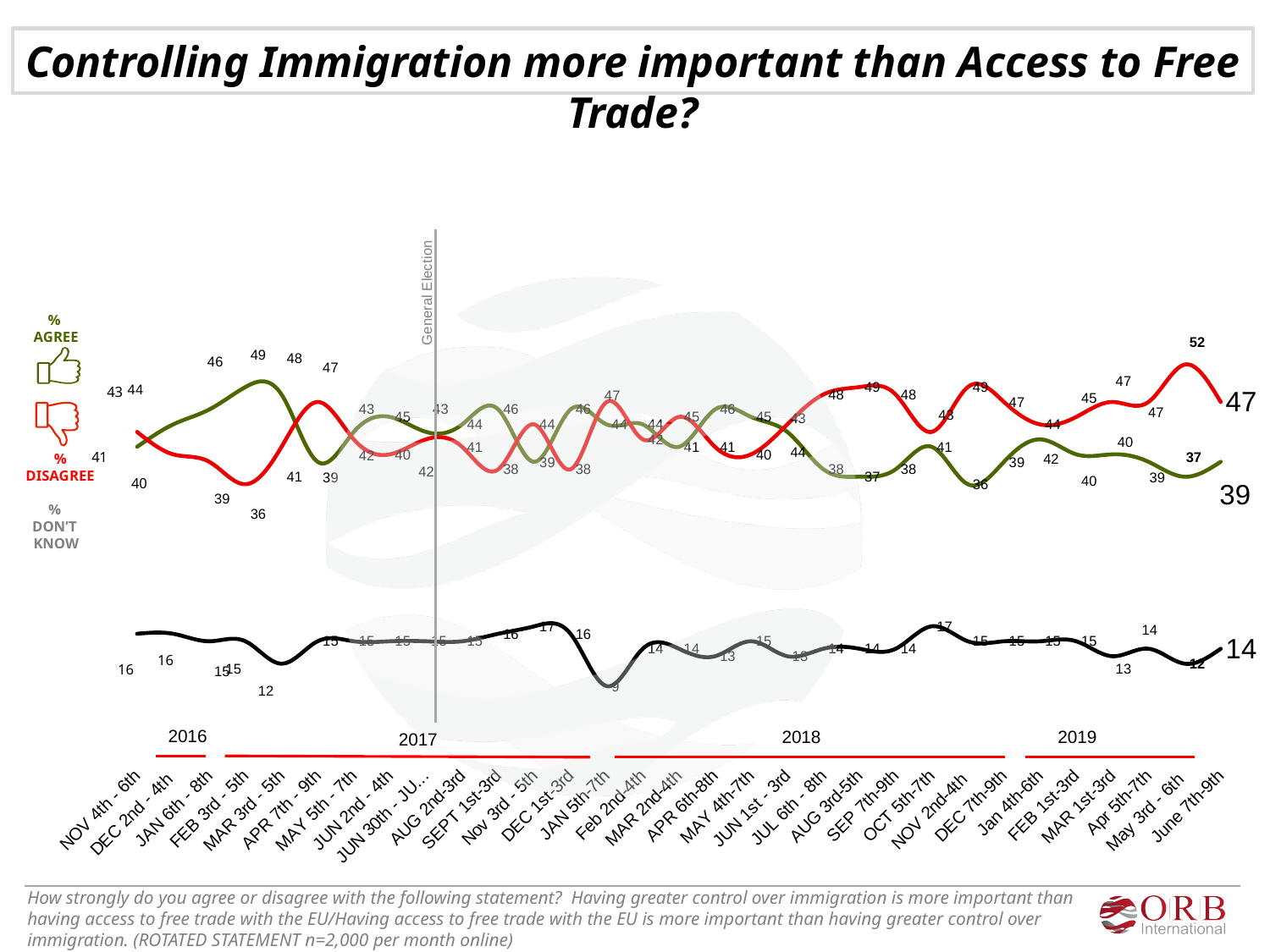
What is the % Disagree value at the final point, June 7th-9th 2019? 47 What is the % Agree value at the final point, June 7th-9th 2019? 39 What is the % Don't Know value at the final point, June 7th-9th 2019? 14 What is the % Agree value at May 3rd-6th 2019, where % Disagree peaks at 52? 37 How many survey dates are listed along the x axis? 31 What is the lowest value reached by the % Don't Know line? 9 What event does the vertical grey line on the chart mark? General Election At June 7th-9th 2019, which is larger, % Agree or % Disagree? % Disagree At May 3rd-6th 2019, what is the difference between the % Disagree value (52) and the % Agree value (37)? 15 What is the highest value reached by the % Disagree line? 52 How many series does the chart's legend list? 3 What kind of chart is shown on the slide? line chart